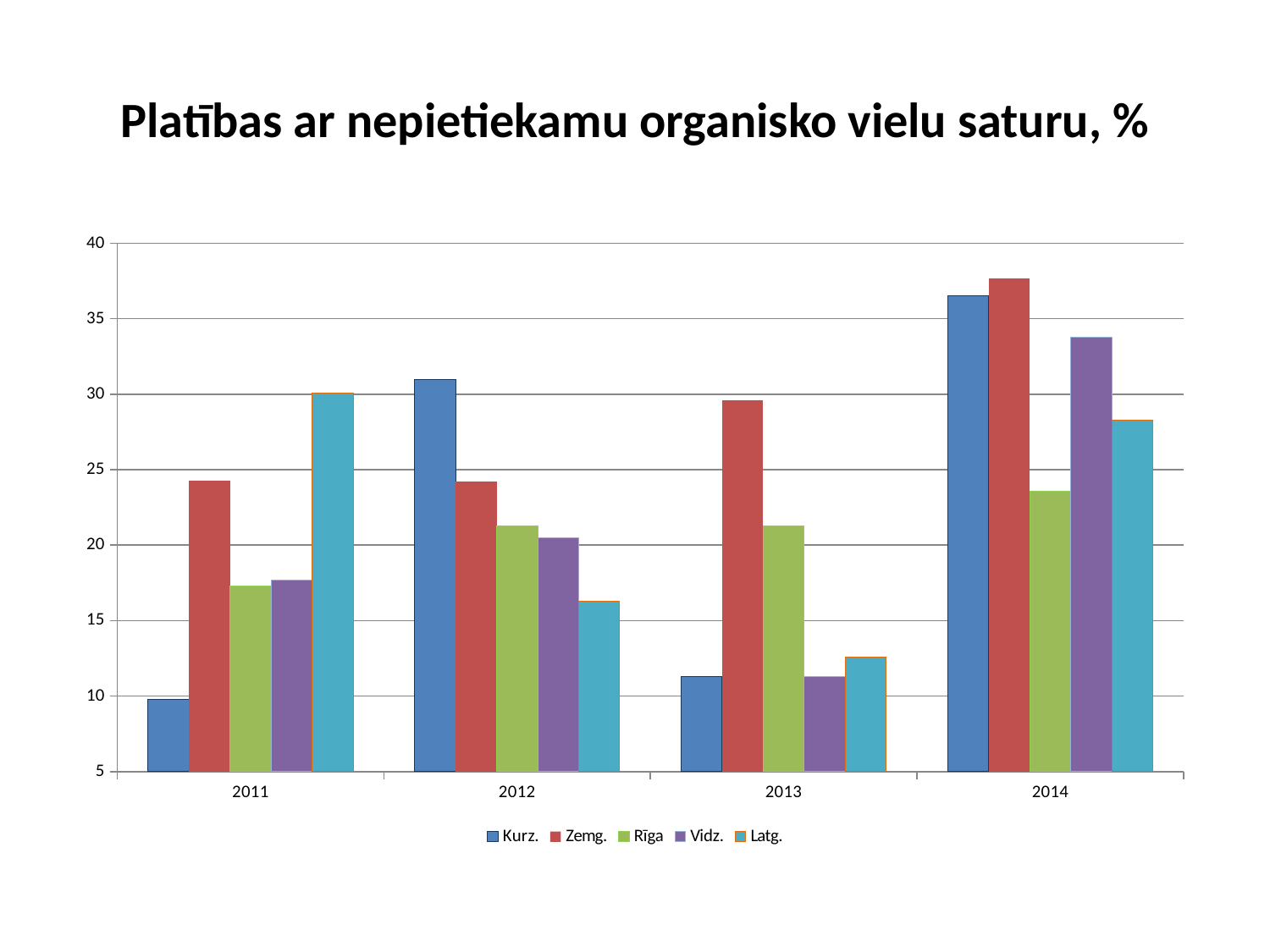
What kind of chart is shown on the slide? bar chart Does the value for Rīga rise or fall from 2013 to 2014? rise Which series has the highest value in 2012? Kurz. How many years are shown on the x axis? 4 Which series has the highest value in 2014? Zemg. Which series has the highest value in 2013? Zemg. How many series does the legend list? 5 Is the value for Kurz. in 2014 greater or less than 35? greater Is the value for Latg. in 2012 greater or less than 20? less What is the title of the chart? Platības ar nepietiekamu organisko vielu saturu, % Which series has the lowest value in 2011? Kurz. Which is larger in 2013, Zemg. or Rīga? Zemg.